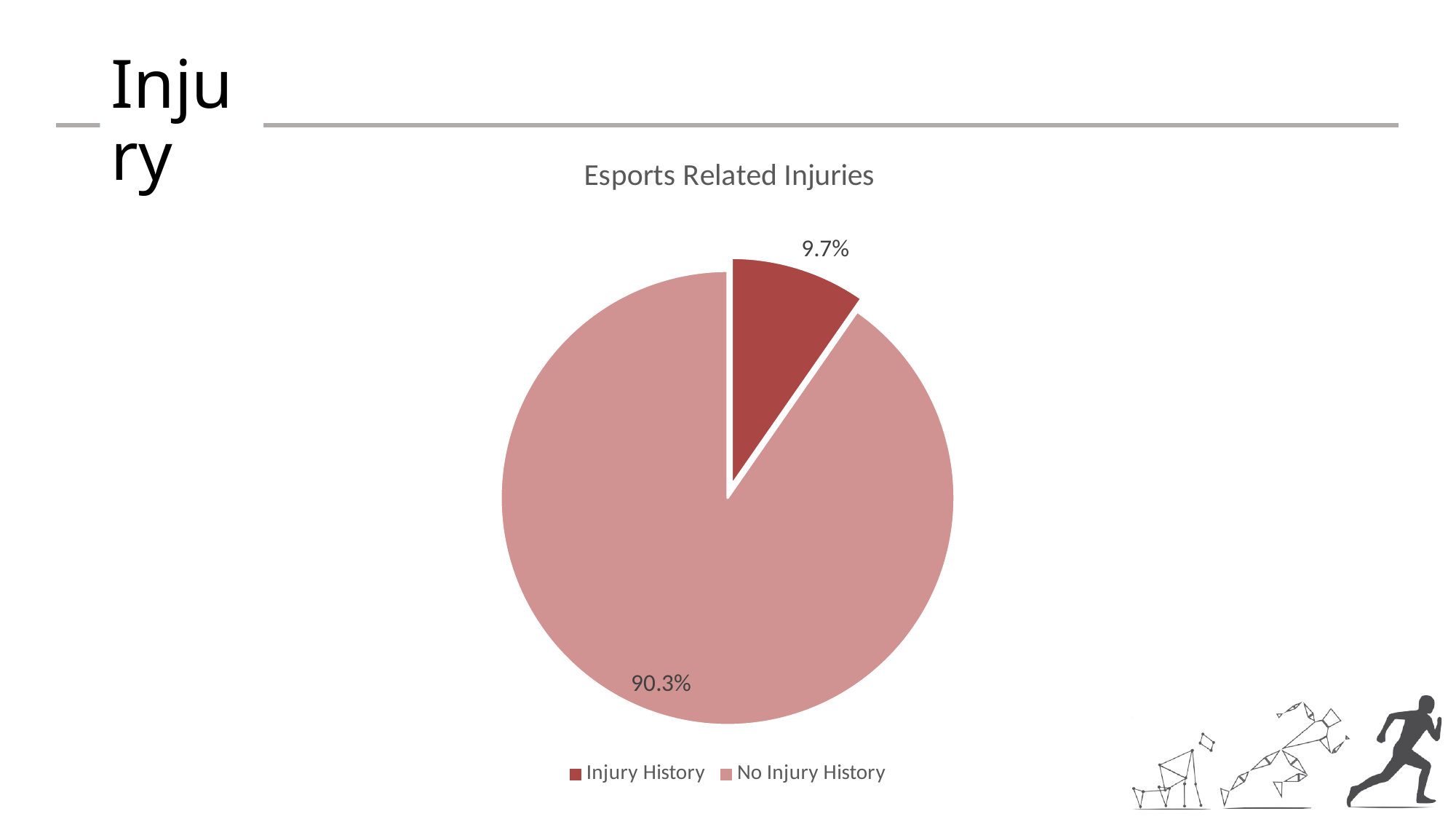
What is the title of the chart? Esports Related Injuries What percentage of the pie is labelled No Injury History? 90.3% Which legend entry is shown in the darker red colour? Injury History What share of the pie does the Injury History slice represent? 9.7% What is the difference in percentage points between the No Injury History slice and the Injury History slice? 80.6 How many slices does the pie chart have? 2 How many entries does the legend list? 2 What type of chart is shown on the slide? Pie chart Which is larger, the Injury History slice or the No Injury History slice? No Injury History Which slice of the pie is the largest? No Injury History Which slice of the pie is the smallest? Injury History What percentage of the pie is labelled Injury History? 9.7%